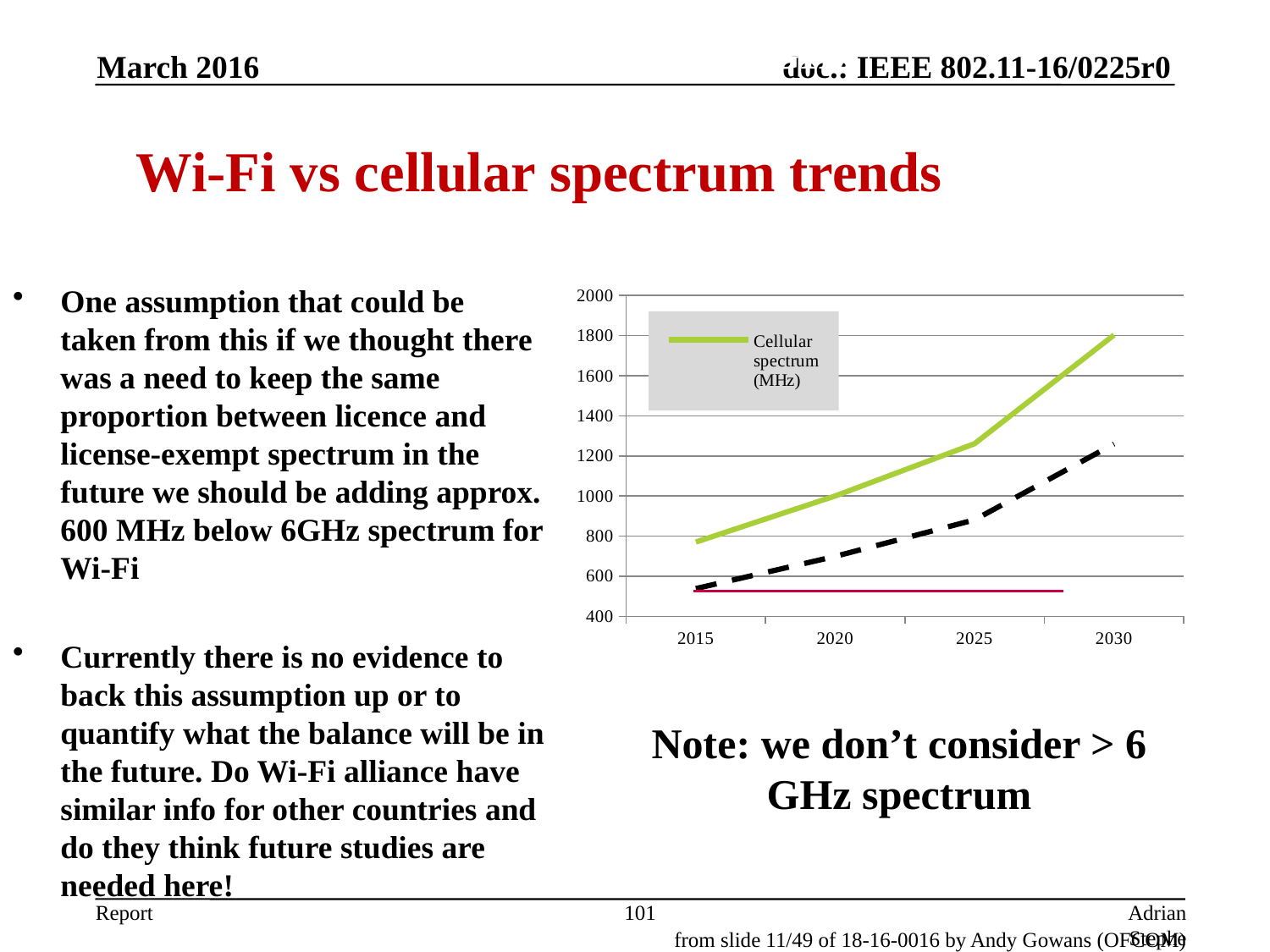
What kind of chart is shown on the slide? line chart What colour is the Cellular spectrum (MHz) line in the chart? green In which year is the Cellular spectrum (MHz) value lowest? 2015 Is the Cellular spectrum (MHz) value for 2030 greater or less than 1600? greater Is the Cellular spectrum (MHz) value for 2015 greater or less than 1000? less Which year has the higher Cellular spectrum (MHz) value, 2015 or 2030? 2030 How many years are labelled on the x axis of the chart? 4 Is the Cellular spectrum (MHz) value for 2025 greater or less than 1000? greater In which year is the Cellular spectrum (MHz) value highest? 2030 Does the Cellular spectrum (MHz) line rise or fall from 2015 to 2030? rise